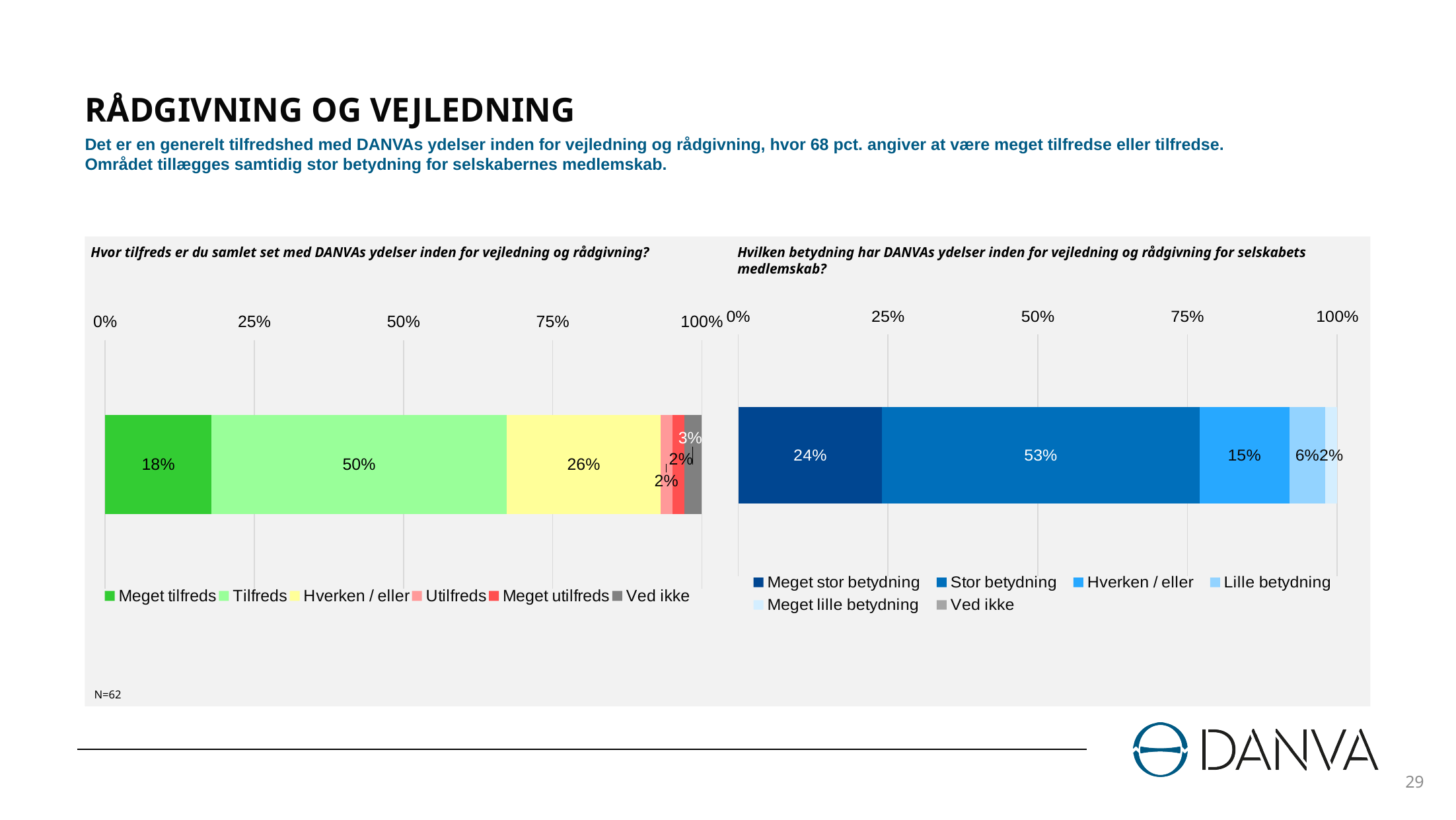
In the right chart (Hvilken betydning har DANVAs ydelser...), how many entries does the legend list? 6 In the right chart (Hvilken betydning har DANVAs ydelser...), which is larger: Meget stor betydning or Hverken / eller? Meget stor betydning In the right chart (Hvilken betydning har DANVAs ydelser...), what percentage answered Lille betydning? 6% What type of chart is used on the left side of the slide? Stacked bar chart In the left chart (Hvor tilfreds er du samlet set...), what percentage answered Tilfreds? 50% In the right chart (Hvilken betydning har DANVAs ydelser...), what percentage answered Stor betydning? 53% In the right chart (Hvilken betydning har DANVAs ydelser...), what percentage answered Meget stor betydning? 24% In the left chart (Hvor tilfreds er du samlet set...), what percentage answered Meget tilfreds? 18% In the left chart (Hvor tilfreds er du samlet set...), what percentage answered Hverken / eller? 26% In the left chart (Hvor tilfreds er du samlet set...), what is the difference between the Tilfreds and Meget tilfreds shares? 32% In the left chart (Hvor tilfreds er du samlet set...), how many entries does the legend list? 6 In the left chart (Hvor tilfreds er du samlet set...), which response category has the largest share? Tilfreds